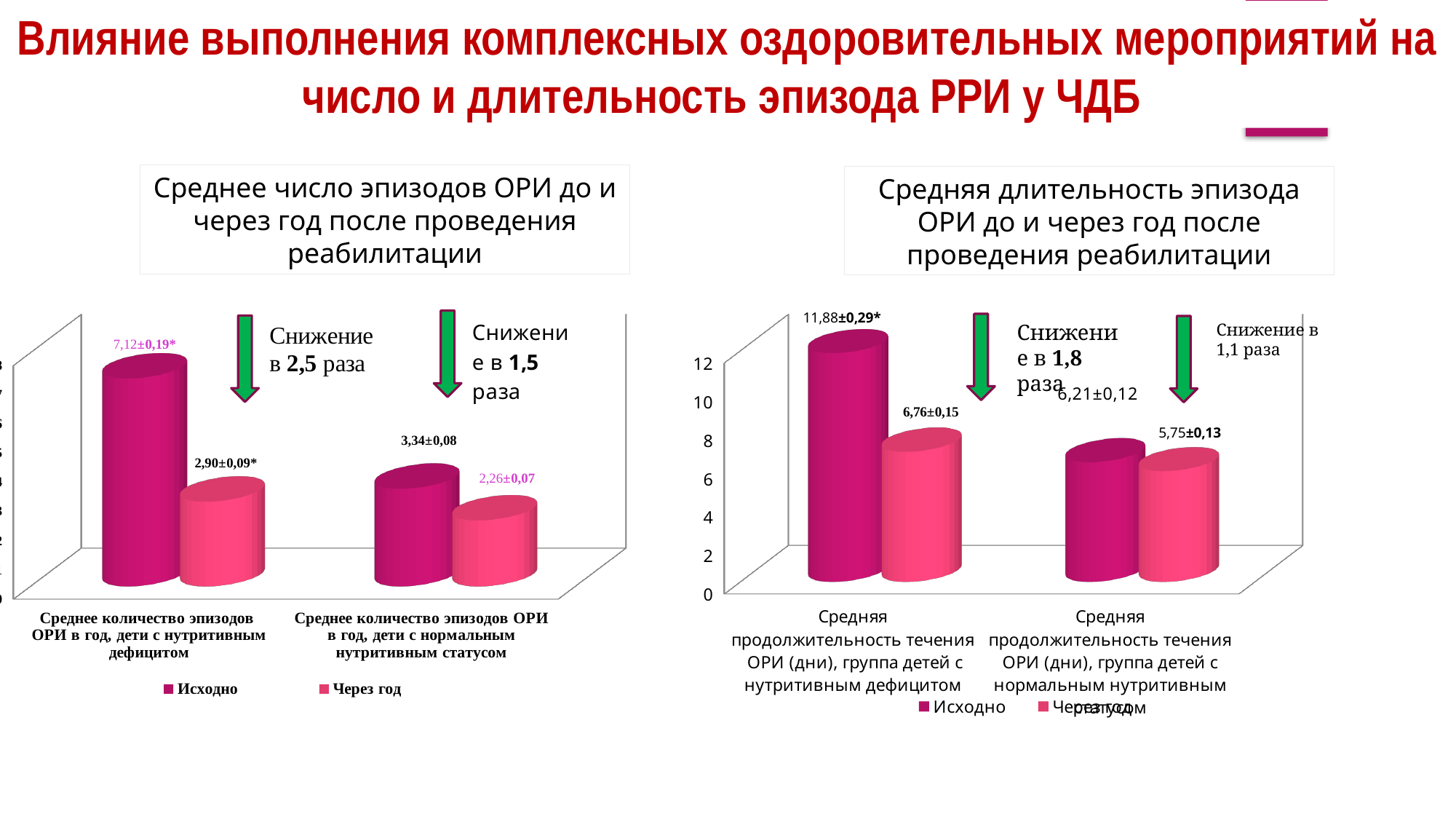
On the left chart (Среднее число эпизодов ОРИ), which bar is the lowest? Через год, children with normal nutritional status (2,26±0,07) On the left chart (Среднее число эпизодов ОРИ), what is the 'Через год' value for children with normal nutritional status? 2,26±0,07 On the right chart (Средняя длительность эпизода ОРИ), is the 'Исходно' value for the group with nutritional deficit greater or less than 10? greater On the right chart (Средняя длительность эпизода ОРИ), what is the 'Через год' value for the group with nutritional deficit? 6,76±0,15 On the left chart (Среднее число эпизодов ОРИ), what is the 'Исходно' value for children with normal nutritional status (нормальным нутритивным статусом)? 3,34±0,08 On the right chart (Средняя длительность эпизода ОРИ), which bar is the highest? Исходно, group with nutritional deficit (11,88±0,29*) What kind of chart is the left chart (Среднее число эпизодов ОРИ)? Bar chart On the right chart (Средняя длительность эпизода ОРИ), what is the 'Исходно' value for the group with nutritional deficit? 11,88±0,29* On the right chart (Средняя длительность эпизода ОРИ), what is the 'Через год' value for the group with normal nutritional status? 5,75±0,13 How many series does the legend of the right chart (Средняя длительность эпизода ОРИ) list? 2 On the left chart (Среднее число эпизодов ОРИ), what is the value labelled for 'Через год' in the group of children with nutritional deficit? 2,90±0,09* On the left chart (Среднее число эпизодов ОРИ), what is the value labelled for 'Исходно' in the group of children with nutritional deficit (дети с нутритивным дефицитом)? 7,12±0,19*